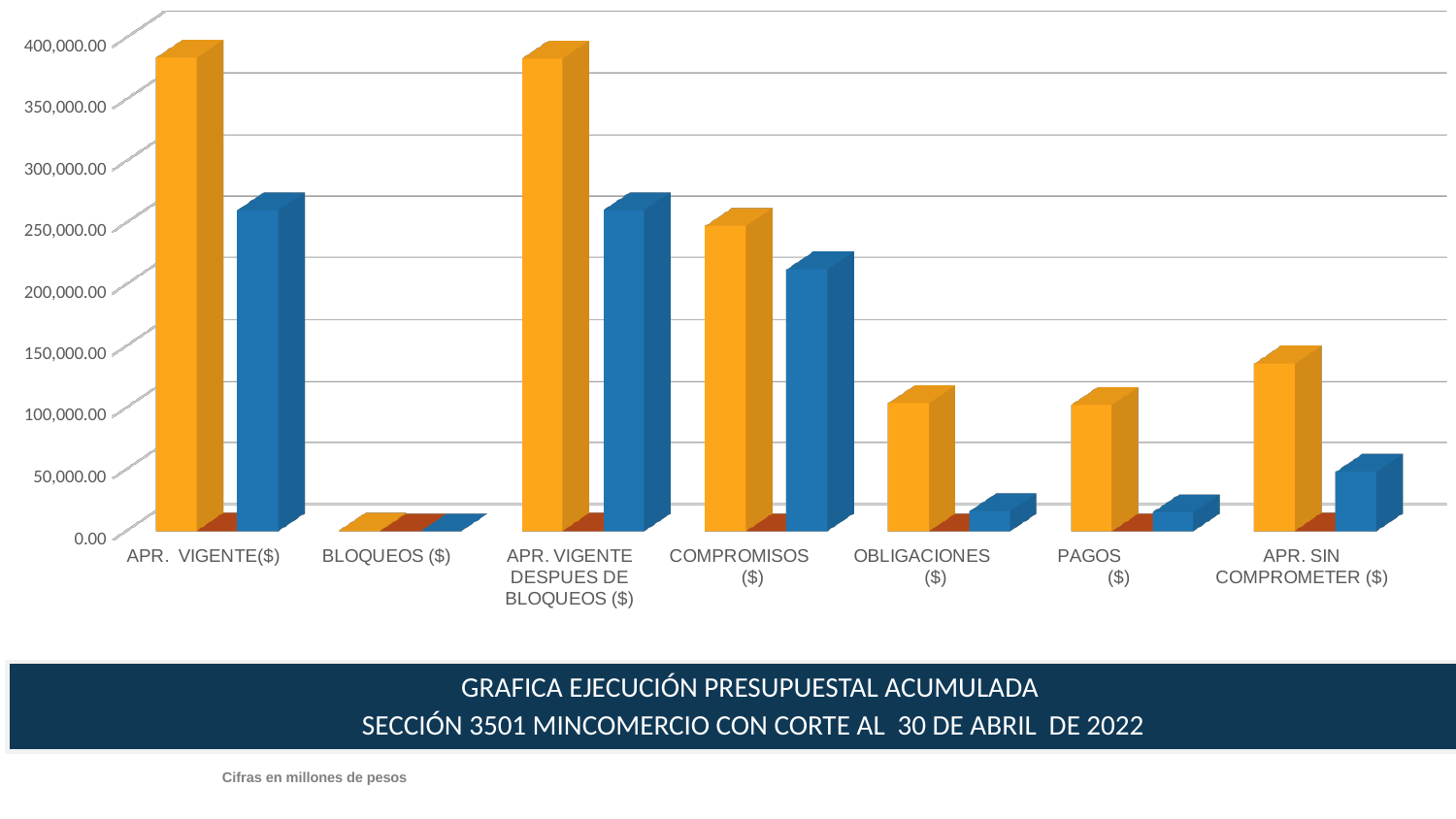
What kind of chart is shown on the slide? Bar chart Is the orange bar for OBLIGACIONES ($) greater or less than 150,000.00? less Is the blue bar for APR. SIN COMPROMETER ($) greater or less than 100,000.00? less Is the blue bar for APR. VIGENTE($) greater or less than 300,000.00? less According to the note below the chart, in what units are the figures expressed? Millones de pesos Which category has the lowest orange bar? BLOQUEOS ($) How many categories are shown on the x axis of the chart? 7 Which orange bar is taller: COMPROMISOS ($) or APR. SIN COMPROMETER ($)? COMPROMISOS ($) Which blue bar is taller: COMPROMISOS ($) or OBLIGACIONES ($)? COMPROMISOS ($)